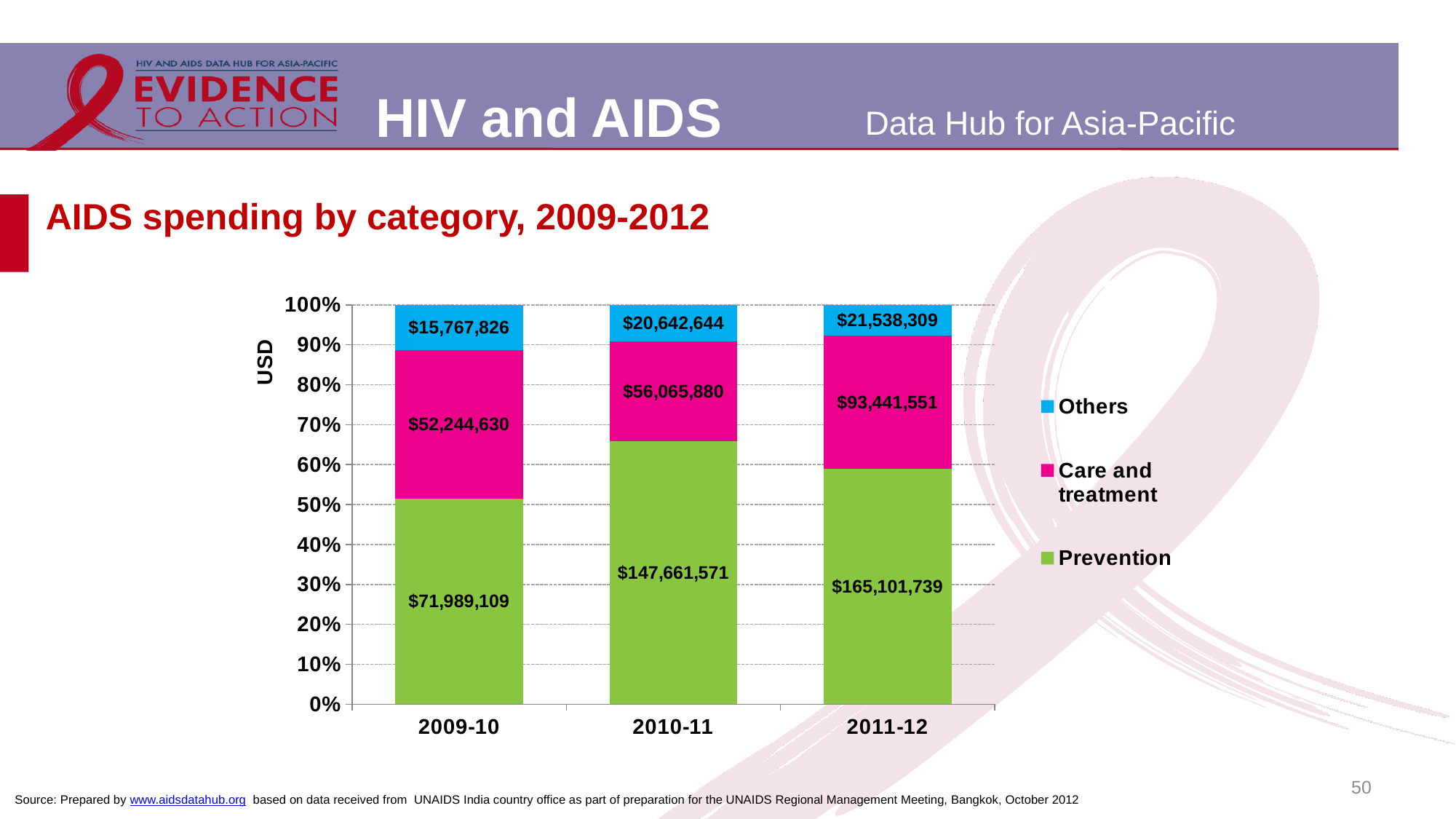
How many years are shown on the x axis? 3 In which year was Prevention spending highest? 2011-12 In which year was Others spending lowest? 2009-10 What is the difference in Prevention spending between 2011-12 and 2010-11? $17,440,168 Which was larger in 2010-11: Care and treatment spending or Others spending? Care and treatment What was the Care and treatment spending in 2011-12? $93,441,551 What was the Prevention spending in 2009-10? $71,989,109 What was the Others spending in 2010-11? $20,642,644 What type of chart is shown on the slide? Stacked bar chart What was the total AIDS spending across all three categories in 2009-10? $140,001,565 How many series does the legend list? 3 How much more was spent on Care and treatment in 2011-12 than in 2010-11? $37,375,671